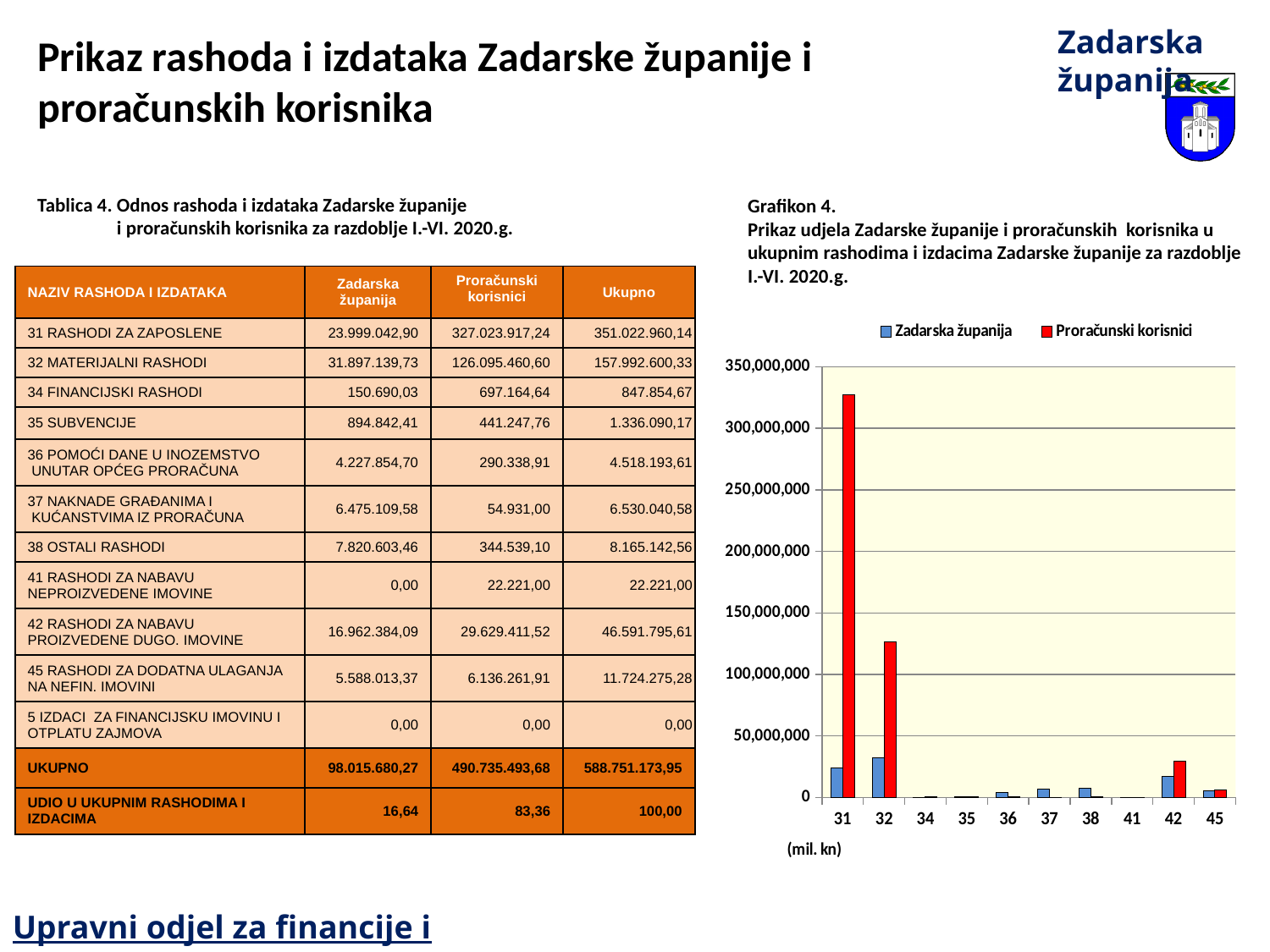
In Grafikon 4, is the Zadarska županija value for category 32 greater or less than 50,000,000? less In Grafikon 4, for category 38, which series has the larger value: Zadarska županija or Proračunski korisnici? Zadarska županija What is the highest value shown on the y axis of Grafikon 4? 350,000,000 In Grafikon 4, is the Proračunski korisnici value for category 31 greater or less than 300,000,000? greater In Grafikon 4, for category 31, which series has the larger value: Zadarska županija or Proračunski korisnici? Proračunski korisnici How many categories are shown on the x axis of Grafikon 4? 10 What colour are the Proračunski korisnici bars in Grafikon 4? red What kind of chart is Grafikon 4? bar chart In Grafikon 4, which category has the highest value for Proračunski korisnici? 31 How many series does the legend of Grafikon 4 list? 2 In Grafikon 4, is the Proračunski korisnici value for category 32 greater or less than 100,000,000? greater In Grafikon 4, which category has the highest value for Zadarska županija? 32